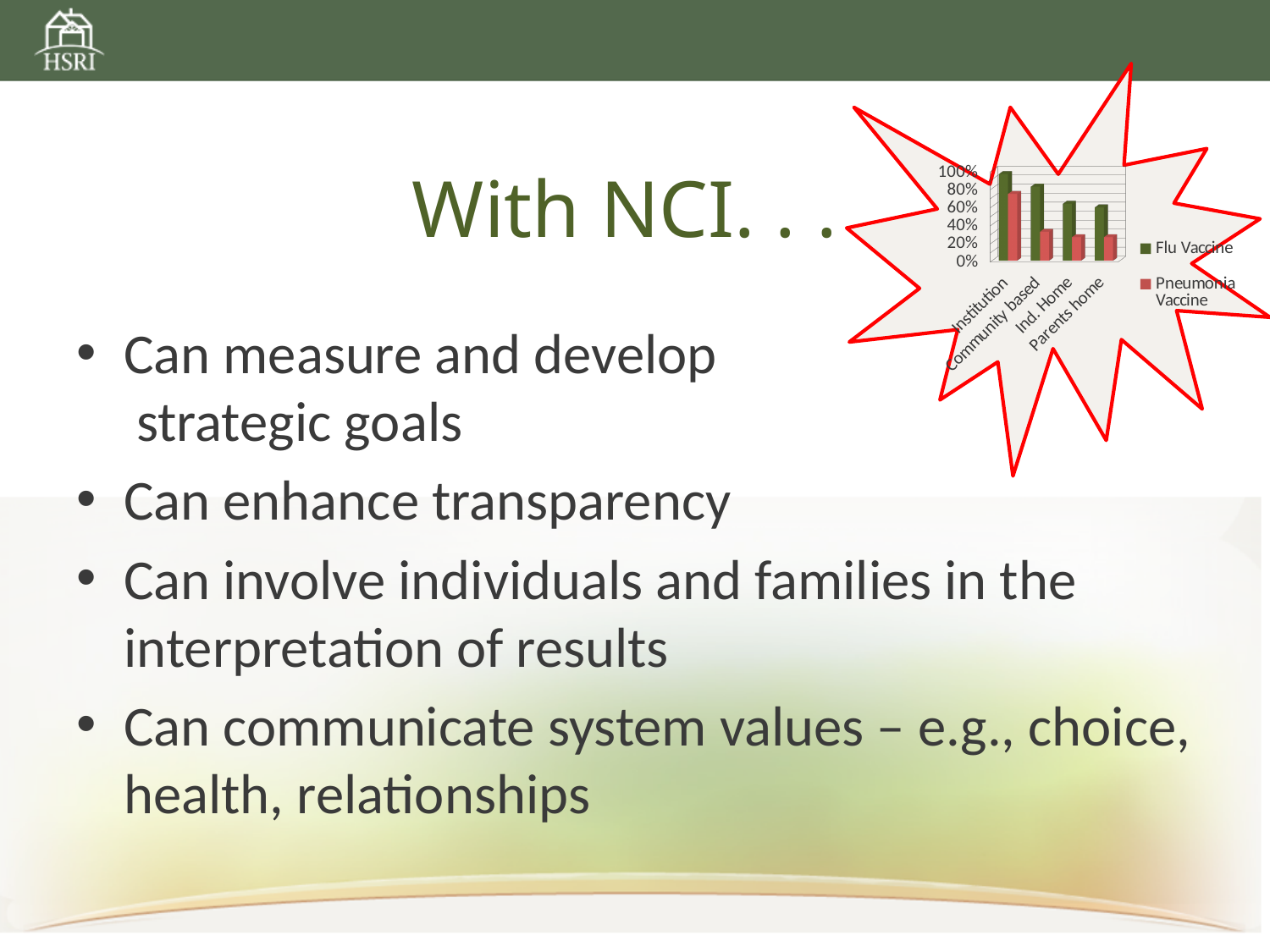
What kind of chart is shown on the slide? bar chart How many series does the chart's legend list? 2 Is the Pneumonia Vaccine value for Community based greater or less than 40%? less Which category has the highest Flu Vaccine value? Institution For Institution, which is larger: Flu Vaccine or Pneumonia Vaccine? Flu Vaccine Is the Pneumonia Vaccine value for Parents home greater or less than 40%? less Is the Flu Vaccine value for Institution greater or less than 80%? greater How many categories are shown on the chart's x axis? 4 Do the Flu Vaccine values rise or fall from Institution to Parents home? fall Which series is shown in green in the chart's legend? Flu Vaccine Which category has the highest Pneumonia Vaccine value? Institution